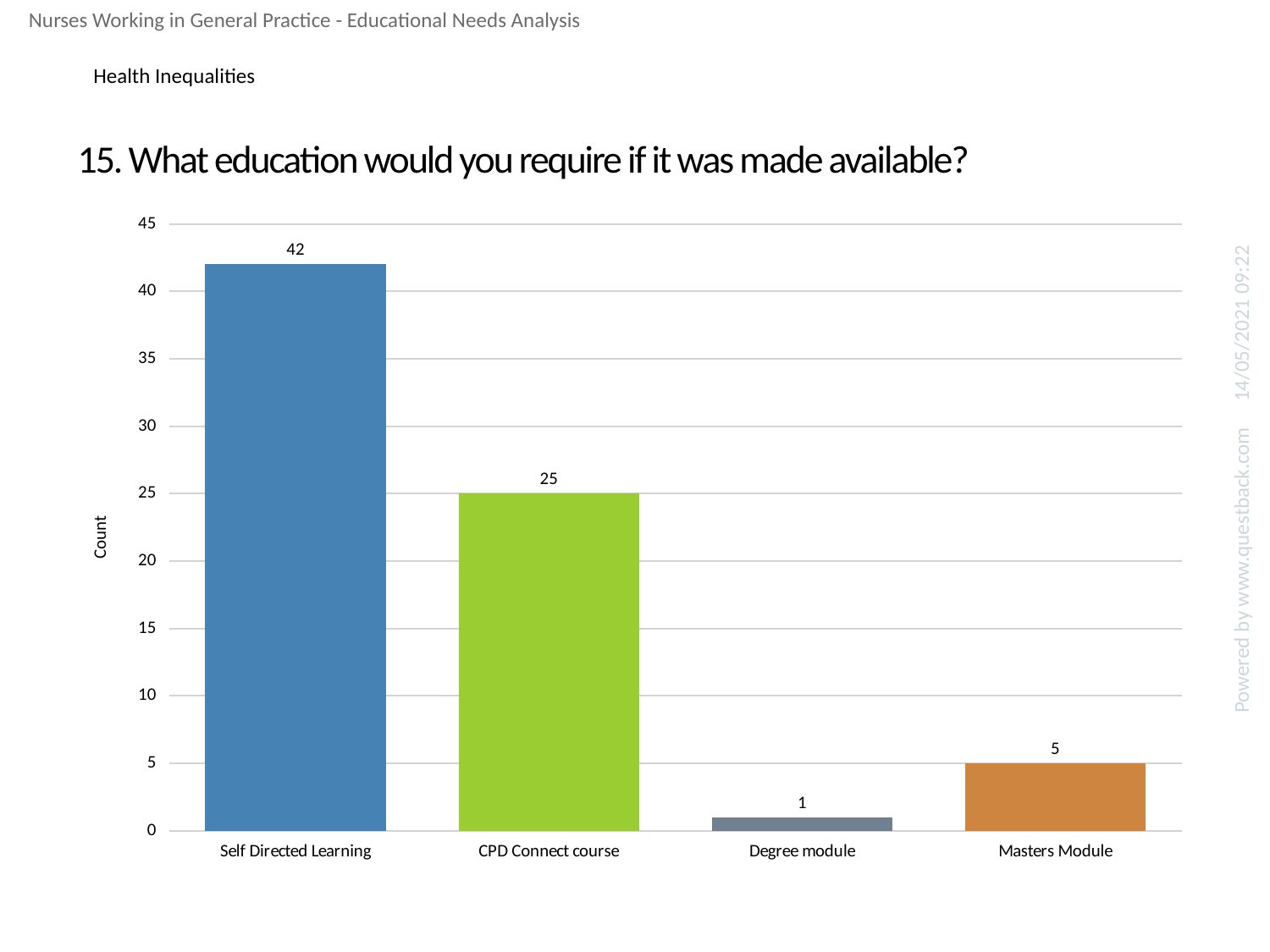
What kind of chart is shown on the slide? Bar chart What is the difference between the counts for Masters Module and Degree module? 4 What is the count for Degree module? 1 Which category has the highest count? Self Directed Learning Which has a larger count, CPD Connect course or Masters Module? CPD Connect course How many categories are shown on the x axis? 4 What is the difference between the counts for Self Directed Learning and CPD Connect course? 17 What is the label of the y axis? Count What is the count for CPD Connect course? 25 Which category has the lowest count? Degree module What is the count for Masters Module? 5 What is the count for Self Directed Learning? 42